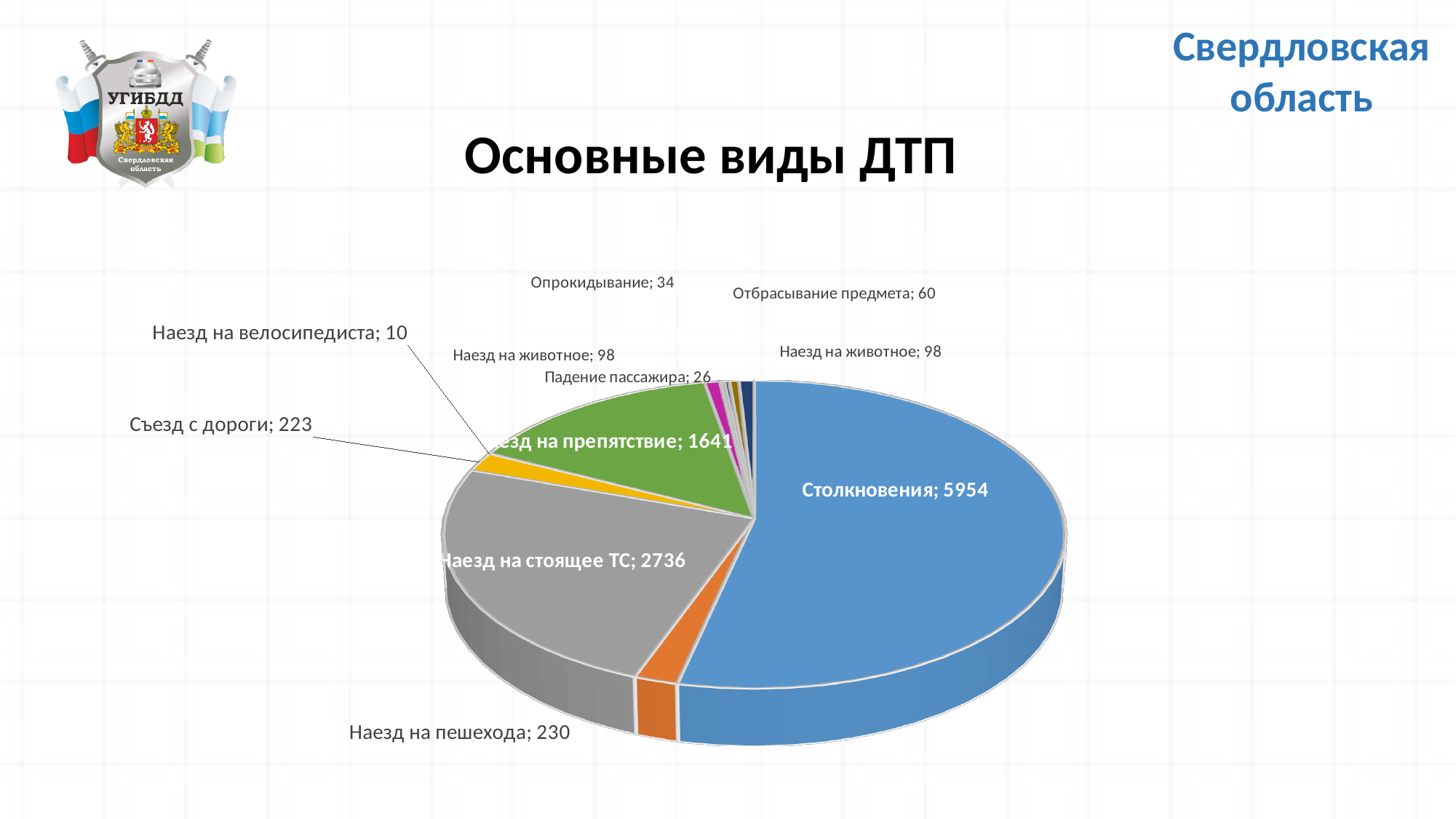
Which is larger, the value for Отбрасывание предмета or the value for Падение пассажира? Отбрасывание предмета What is the value for Опрокидывание? 34 What is the value for Наезд на пешехода? 230 What kind of chart is shown on the slide? pie chart Which category has the smallest value in the chart? Наезд на велосипедиста Which category has the largest slice of the pie? Столкновения What is the title of the chart on the slide? Основные виды ДТП What is the value for Съезд с дороги? 223 What is the value for Наезд на препятствие? 1641 What is the difference between the values for Столкновения and Наезд на стоящее ТС? 3218 What is the value for Наезд на стоящее ТС? 2736 What is the value for Столкновения? 5954